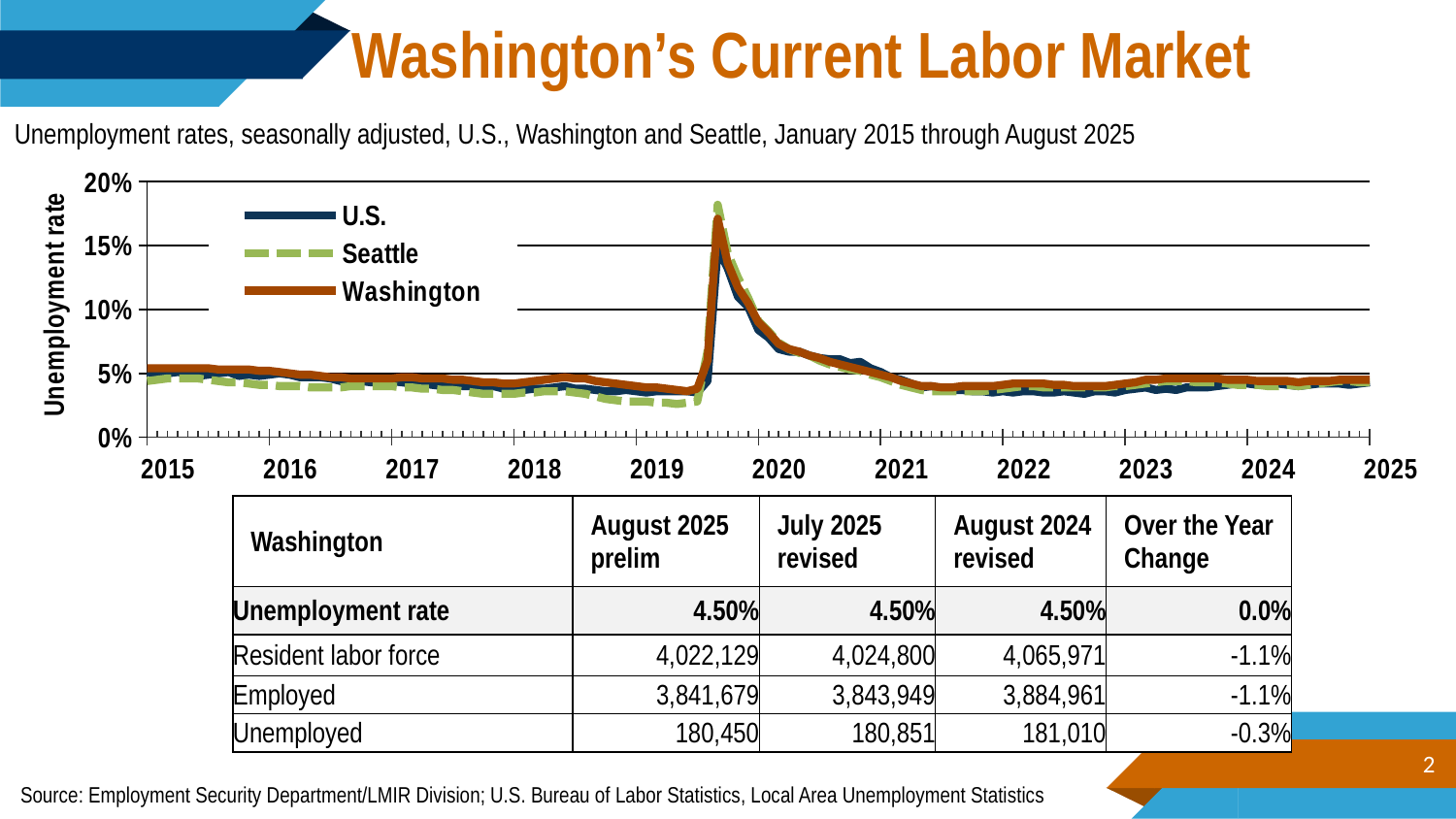
How many series does the chart's legend list? 3 Which series has the lowest unemployment rate during 2019? Seattle Which series reaches the highest unemployment rate at the 2020 peak? Seattle Is the peak value for Seattle in 2020 greater or less than 15%? greater Is the value for Seattle at the start of 2019 greater or less than 5%? less What kind of chart is shown on the slide? line chart Is the value for Washington at the start of 2015 greater or less than 10%? less Which series are listed in the chart's legend? U.S., Seattle, Washington Do the unemployment rates rise or fall between the 2020 peak and the end of 2021? fall In 2019, which is higher: the Seattle rate or the Washington rate? Washington What is the label on the chart's vertical axis? Unemployment rate